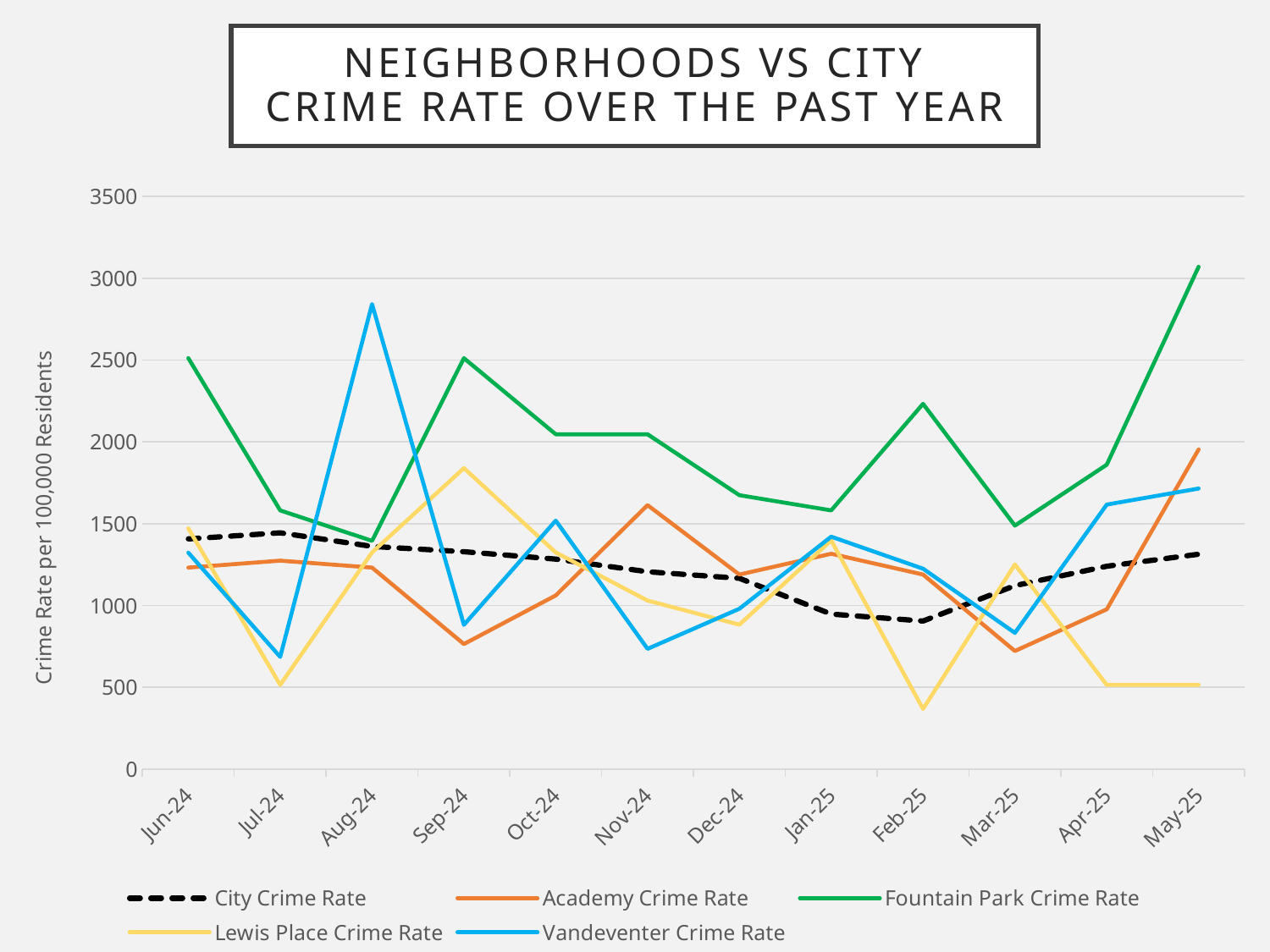
What kind of chart is shown on the slide? Line chart Is the Vandeventer Crime Rate for Aug-24 greater or less than 2500? greater In which month is the Fountain Park Crime Rate highest? May-25 Which series has the highest value in May-25? Fountain Park Crime Rate How many series does the legend list? 5 In which month is the Lewis Place Crime Rate lowest? Feb-25 Does the City Crime Rate rise or fall from Jul-24 to Feb-25? Fall Is the Fountain Park Crime Rate for May-25 greater or less than 3000? greater In Aug-24, which is higher: the Vandeventer Crime Rate or the Fountain Park Crime Rate? Vandeventer Crime Rate How many months are plotted along the x axis? 12 In Jun-24, which is higher: the Fountain Park Crime Rate or the Vandeventer Crime Rate? Fountain Park Crime Rate Is the Lewis Place Crime Rate for Feb-25 greater or less than 500? less